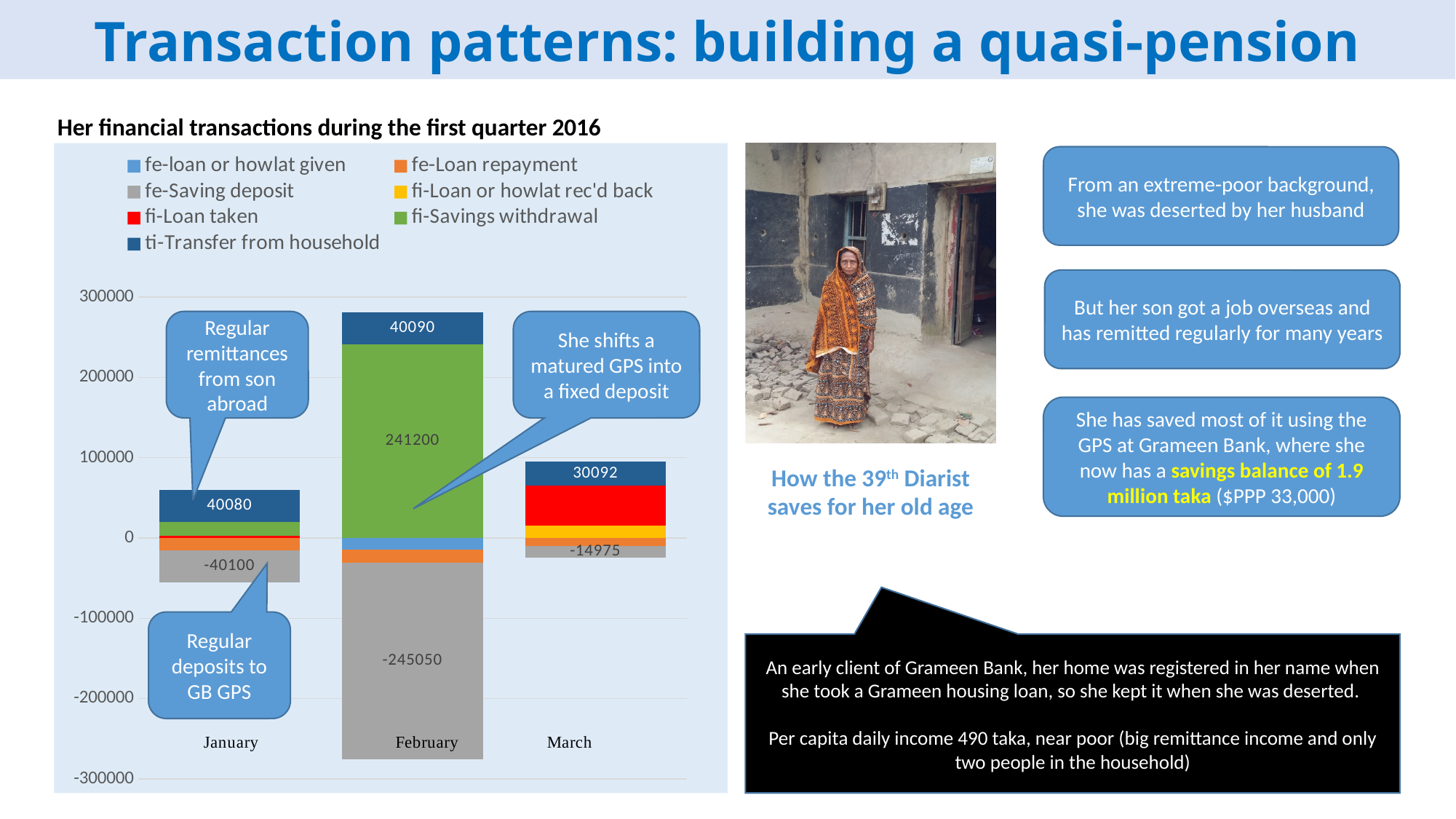
What is the difference between the ti-Transfer from household values in February and January? 10 What is the value of fe-Saving deposit in February? -245050 What is the value of fe-Saving deposit in March? -14975 What is the value of fi-Savings withdrawal in February? 241200 In which month is the fe-Saving deposit the most negative? February What is the value of ti-Transfer from household in January? 40080 In which month is the ti-Transfer from household value lowest? March How many series does the chart legend list? 7 What type of chart is shown on the slide? stacked bar chart What is the value of ti-Transfer from household in March? 30092 Which colour represents fi-Loan taken in the chart legend? red How many months are shown on the x axis of the chart? 3